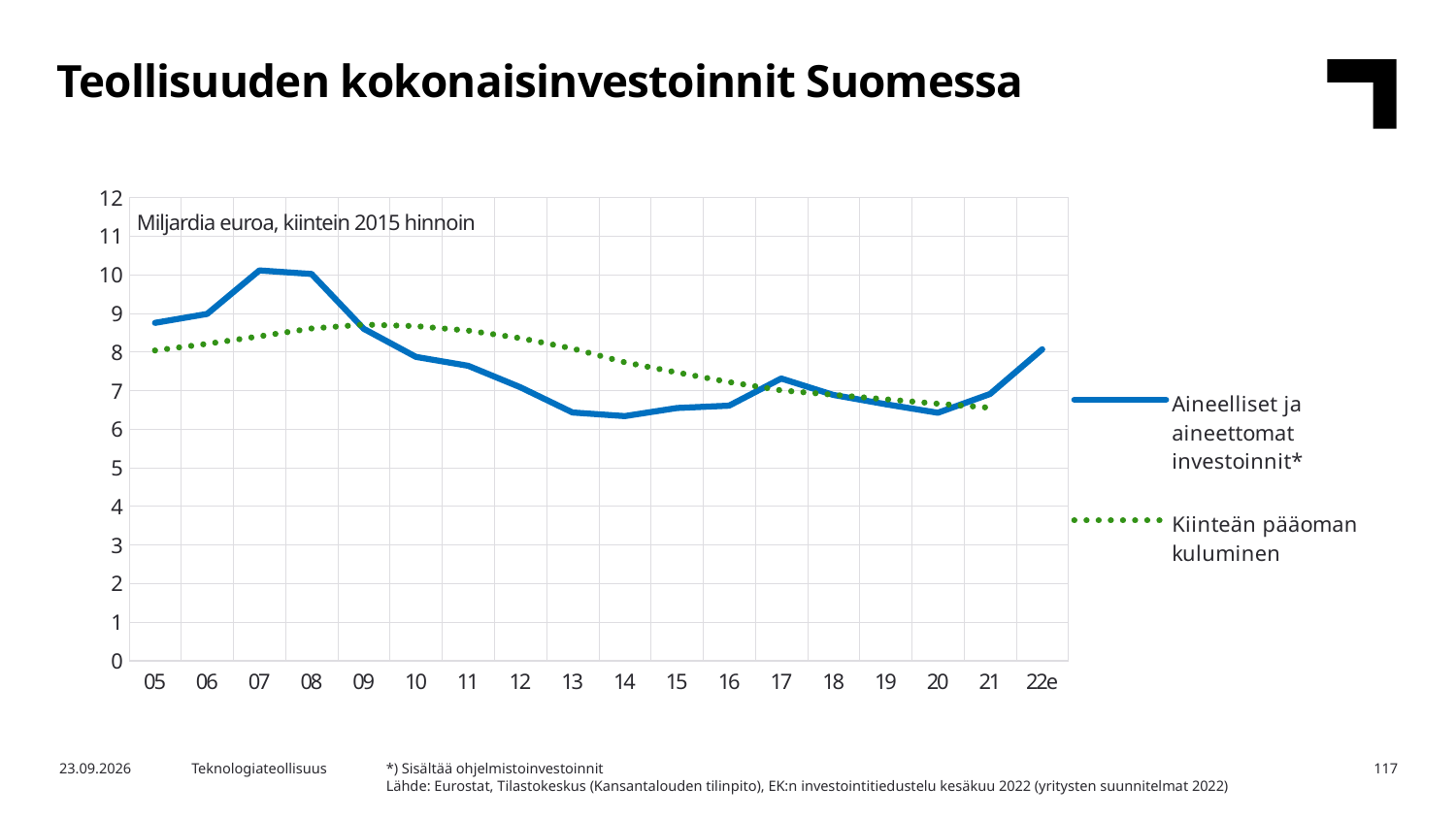
What is the title of the chart? Teollisuuden kokonaisinvestoinnit Suomessa Is the value of 'Aineelliset ja aineettomat investoinnit*' in 14 greater or less than 7? less Is the value of 'Aineelliset ja aineettomat investoinnit*' in 05 greater or less than 8? greater Is the value of 'Kiinteän pääoman kuluminen' in 21 greater or less than 7? less What unit is stated inside the chart area? Miljardia euroa, kiintein 2015 hinnoin Does the 'Aineelliset ja aineettomat investoinnit*' line rise or fall from 08 to 14? Fall How many series does the legend list? 2 In 13, which series has the higher value: 'Aineelliset ja aineettomat investoinnit*' or 'Kiinteän pääoman kuluminen'? Kiinteän pääoman kuluminen How many years (categories) are shown on the x axis? 18 What kind of chart is shown on the slide? Line chart In 07, which series has the higher value: 'Aineelliset ja aineettomat investoinnit*' or 'Kiinteän pääoman kuluminen'? Aineelliset ja aineettomat investoinnit*